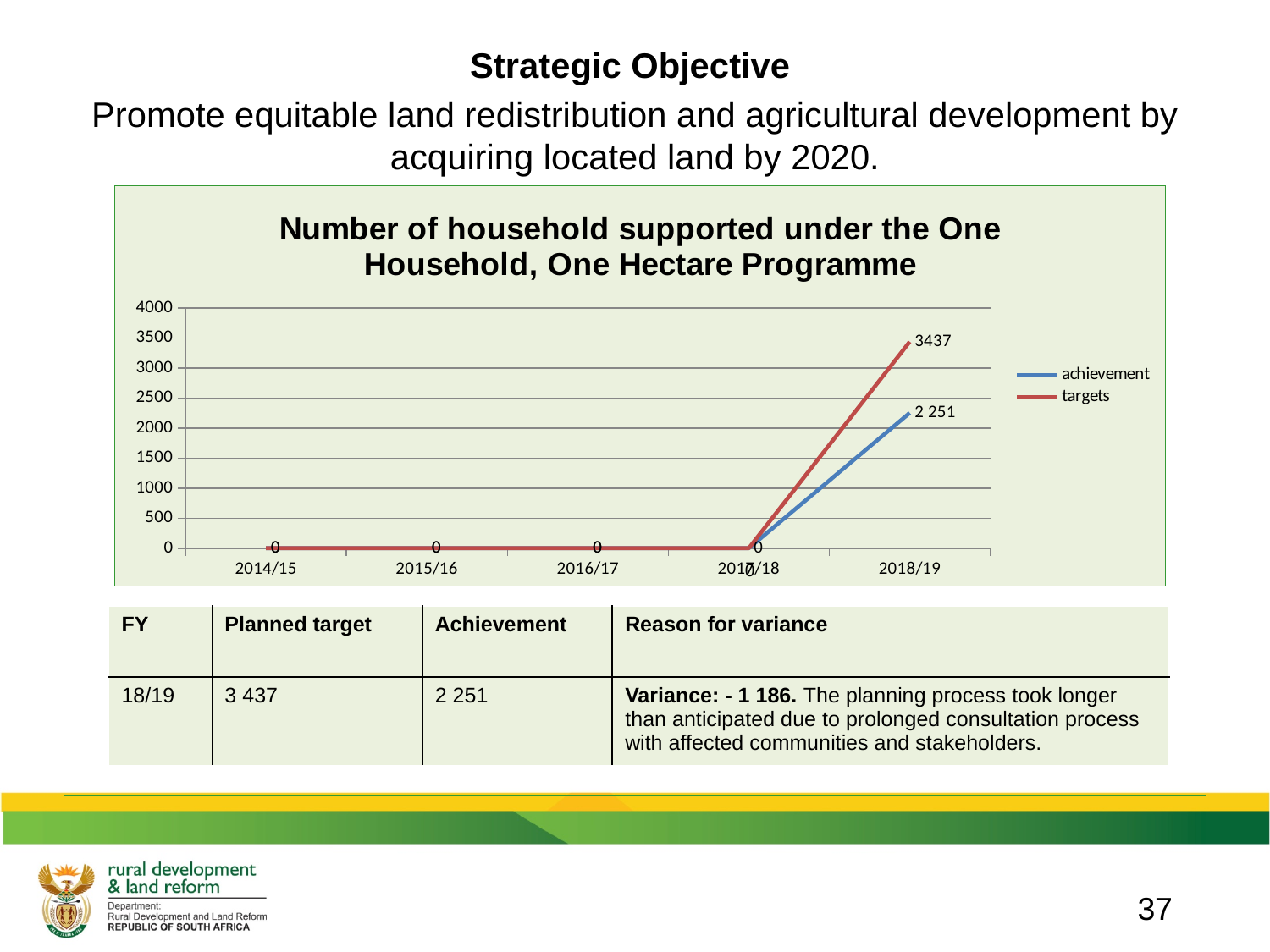
What type of chart is shown on the slide? line chart How many series does the chart legend list? 2 What is the difference between the targets value and the achievement value in 2018/19? 1 186 What is the title of the chart? Number of household supported under the One Household, One Hectare Programme Is the achievement value for 2018/19 greater or less than 2500? less In 2018/19, which is larger, the targets value or the achievement value? targets How many financial years are shown on the x axis of the chart? 5 Which series is drawn in red? targets Which year has the highest targets value? 2018/19 What is the achievement value for 2016/17? 0 What is the targets value for 2018/19? 3437 What is the achievement value for 2018/19? 2 251